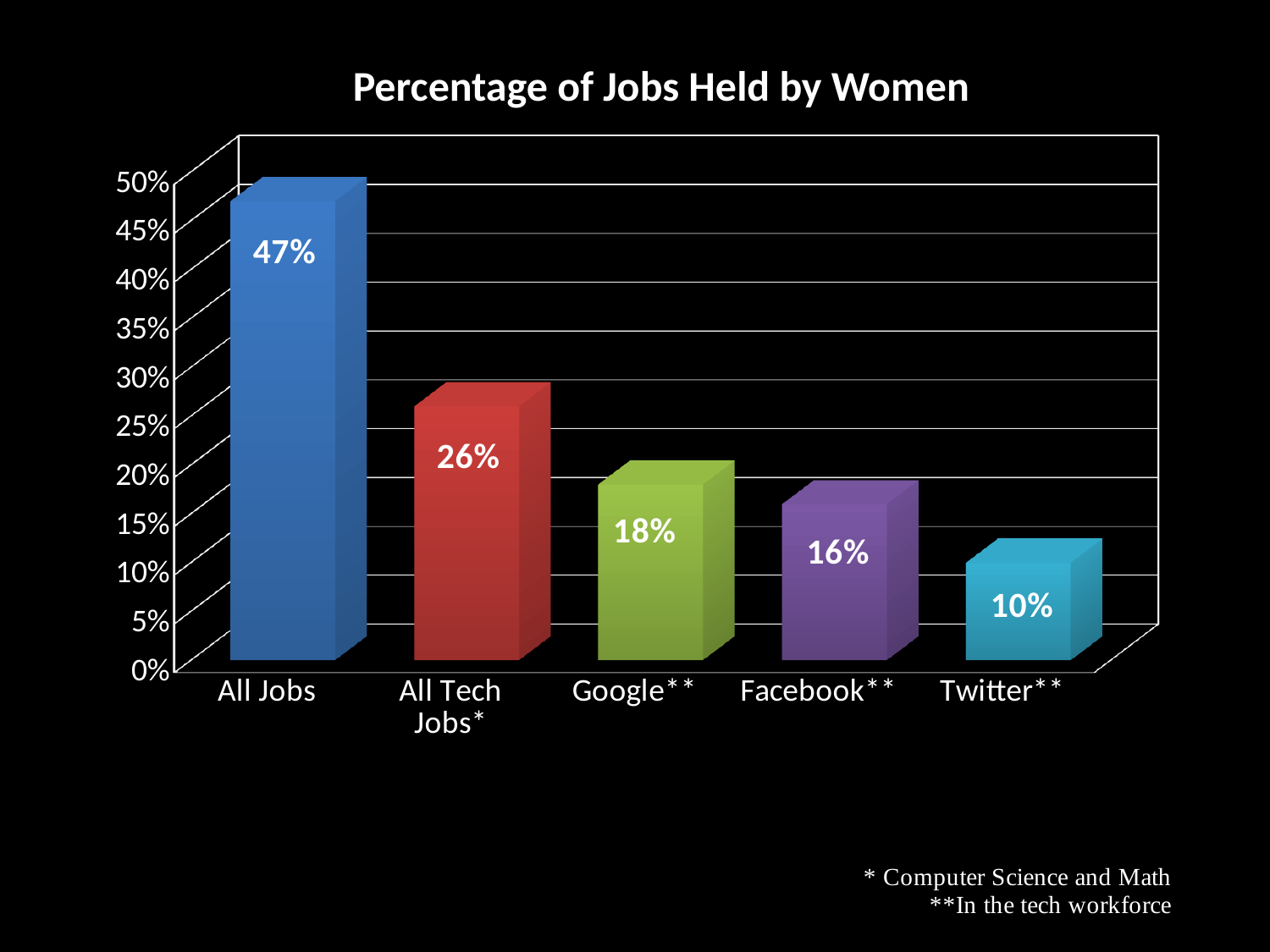
How many categories are shown in the chart? 5 What is the difference between the percentage for Google and Facebook? 2% Which category has the highest percentage of jobs held by women? All Jobs What is the percentage of jobs held by women for All Jobs? 47% What is the title of the chart? Percentage of Jobs Held by Women Which has a higher percentage of jobs held by women, Facebook or Twitter? Facebook What is the difference between the percentage for All Jobs and All Tech Jobs? 21% What is the percentage of jobs held by women at Twitter? 10% Which category has the lowest percentage of jobs held by women? Twitter** What kind of chart is shown on the slide? Bar chart What is the percentage of jobs held by women for All Tech Jobs? 26% What is the percentage of jobs held by women at Google? 18%